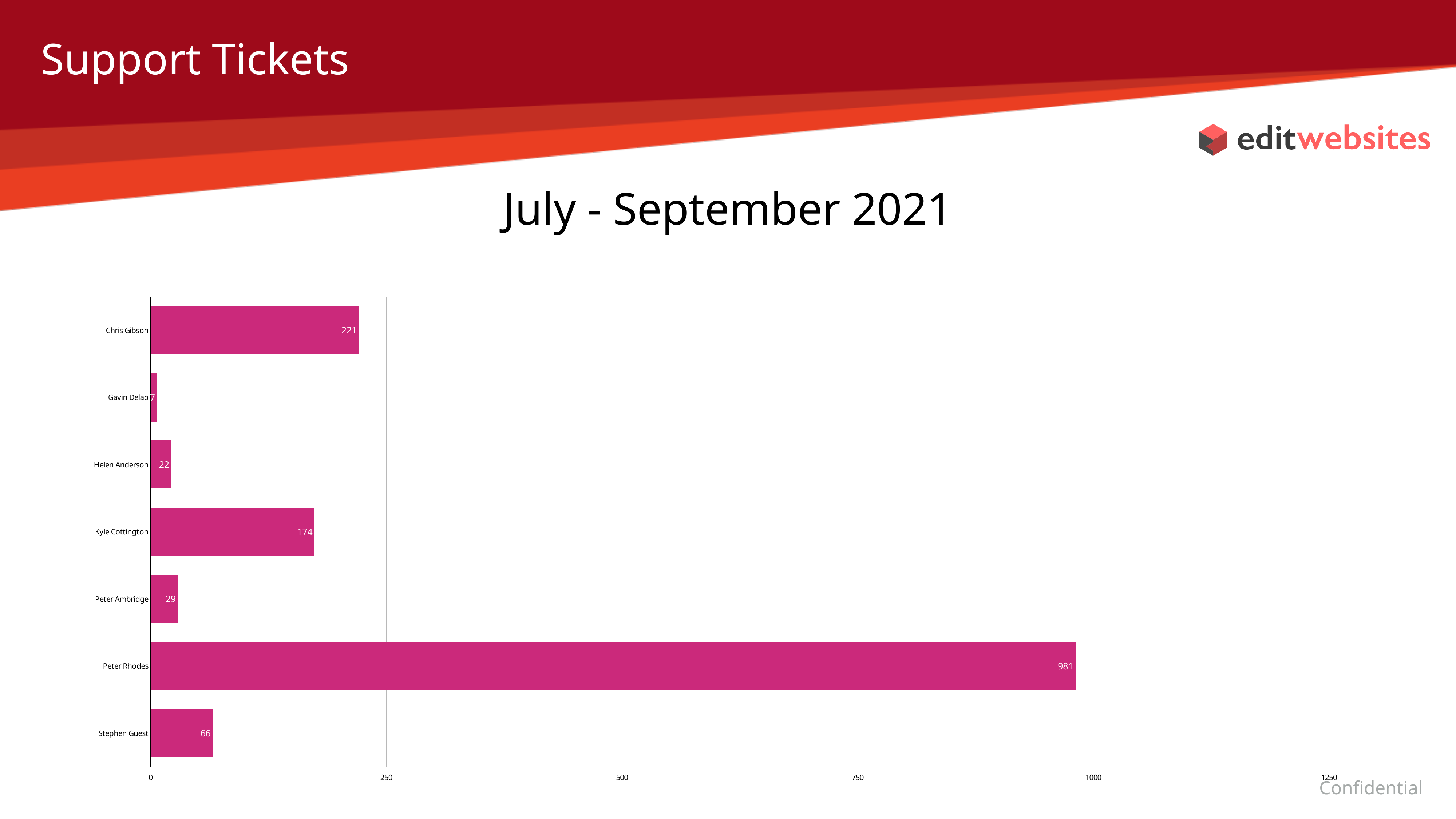
How many support tickets did Peter Rhodes have? 981 What is the value shown for Kyle Cottington? 174 What is the value shown for Chris Gibson? 221 Who has the highest number of support tickets? Peter Rhodes How many people are shown on the chart? 7 What is the value shown for Stephen Guest? 66 What is the difference between Peter Rhodes's and Chris Gibson's values? 760 Who has more support tickets, Kyle Cottington or Stephen Guest? Kyle Cottington What is the difference between Peter Ambridge's and Helen Anderson's values? 7 What kind of chart is shown on the slide? Bar chart Who has the lowest number of support tickets? Gavin Delap Is the value for Peter Rhodes greater or less than 750? greater